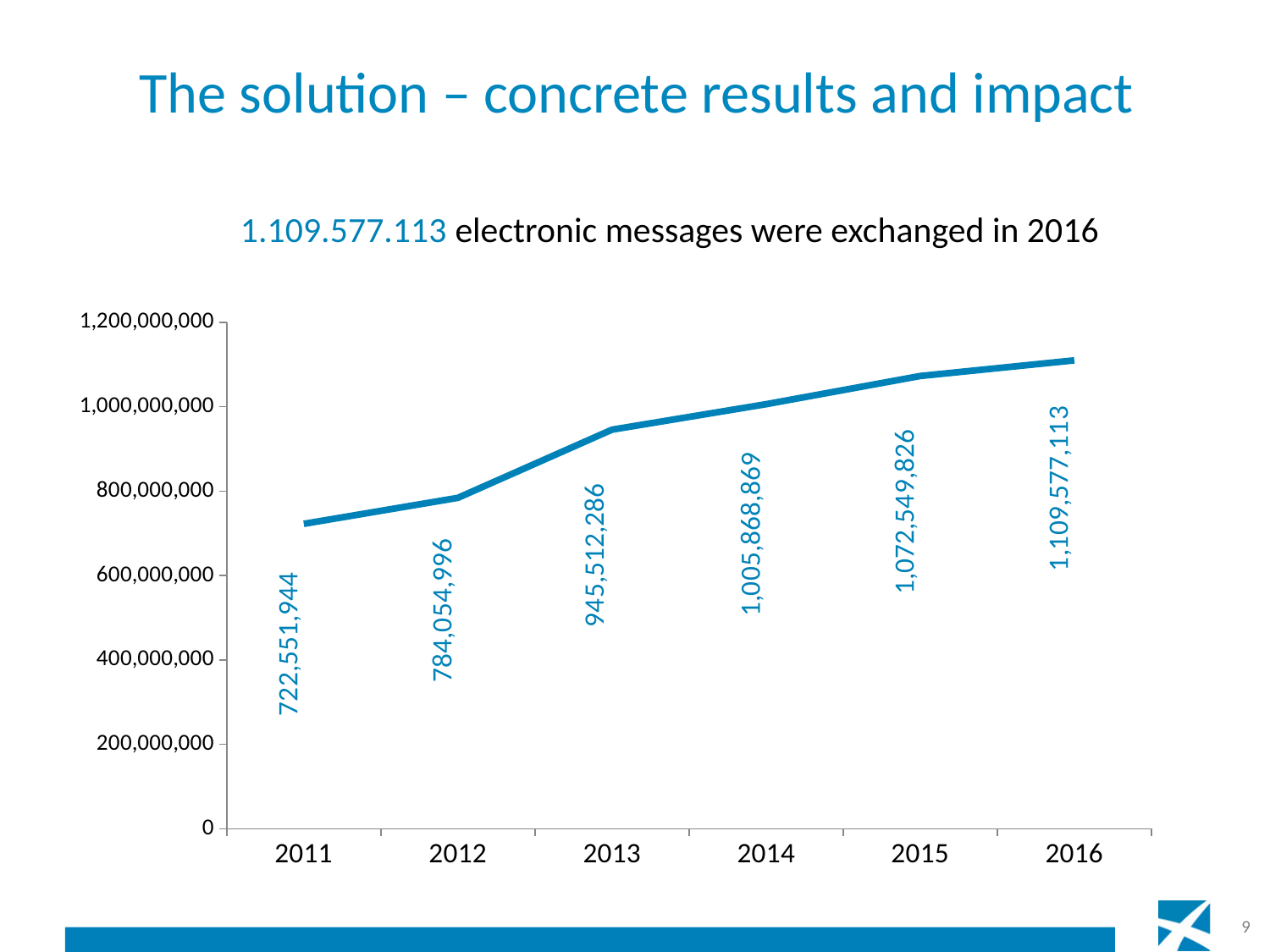
What value is shown for 2016? 1,109,577,113 Which year has the lowest value? 2011 Which is larger, the value for 2015 or the value for 2014? 2015 What kind of chart is shown on the slide? line chart What value is shown for 2011? 722,551,944 What is the difference between the values for 2013 and 2012? 161,457,290 Which year has the highest value? 2016 What value is shown for 2014? 1,005,868,869 How many years are plotted on the chart? 6 Is the value for 2012 greater or less than 800,000,000? less What is the difference between the values for 2016 and 2011? 387,025,169 What value is shown for 2013? 945,512,286